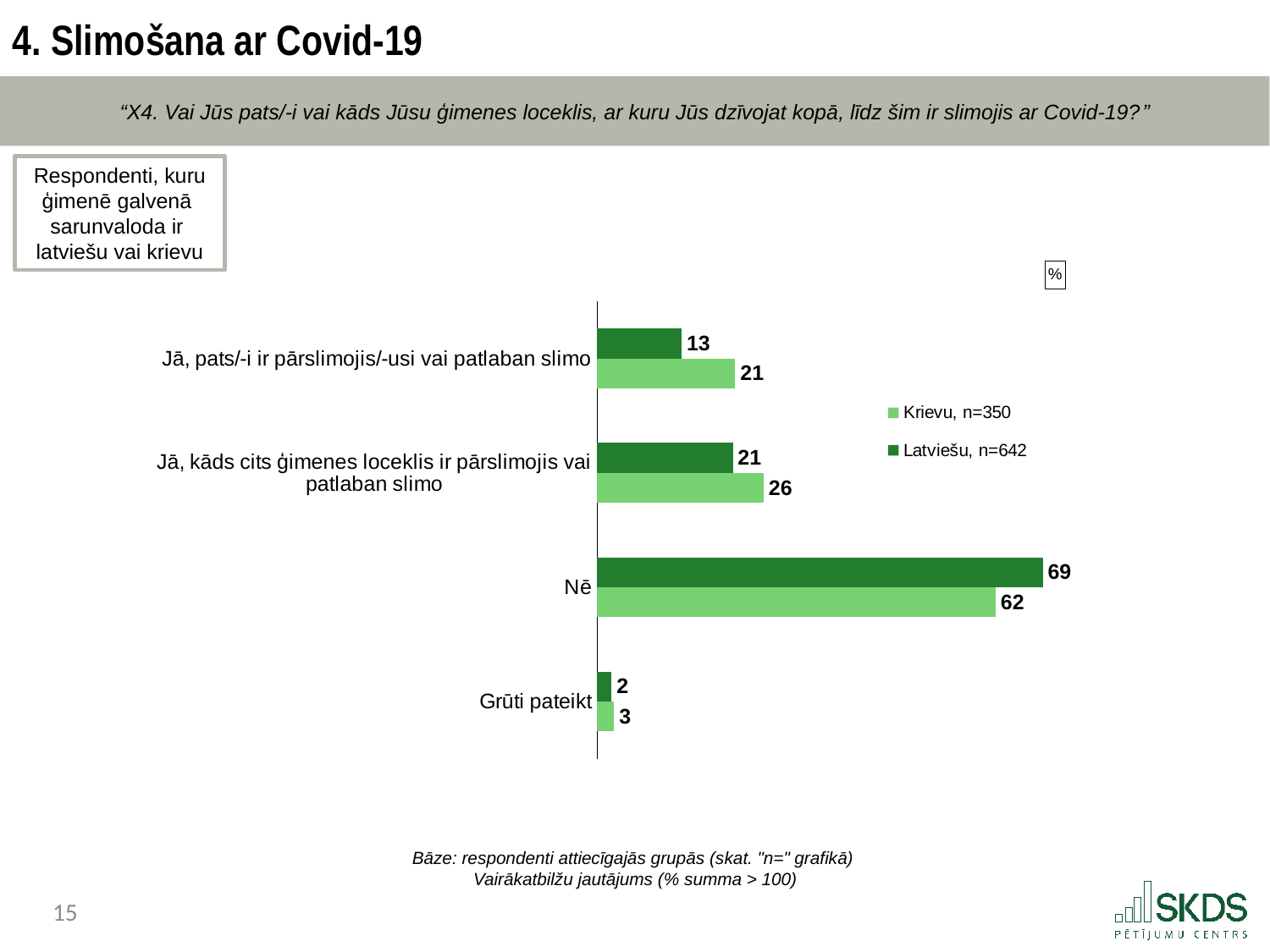
How many series does the legend list? 2 What is the difference between the Latviešu, n=642 and Krievu, n=350 values in the category "Nē"? 7 Which series is shown in dark green? Latviešu, n=642 What is the value for Krievu, n=350 in the category "Jā, kāds cits ģimenes loceklis ir pārslimojis vai patlaban slimo"? 26 In the category "Jā, pats/-i ir pārslimojis/-usi vai patlaban slimo", which series has the larger value, Krievu, n=350 or Latviešu, n=642? Krievu, n=350 What kind of chart is shown on the slide? Bar chart How many categories are shown on the chart? 4 What is the value for Latviešu, n=642 in the category "Nē"? 69 Which category has the lowest value for Latviešu, n=642? Grūti pateikt What is the value for Latviešu, n=642 in the category "Grūti pateikt"? 2 Which category has the highest value for Krievu, n=350? Nē What is the value for Krievu, n=350 in the category "Jā, pats/-i ir pārslimojis/-usi vai patlaban slimo"? 21